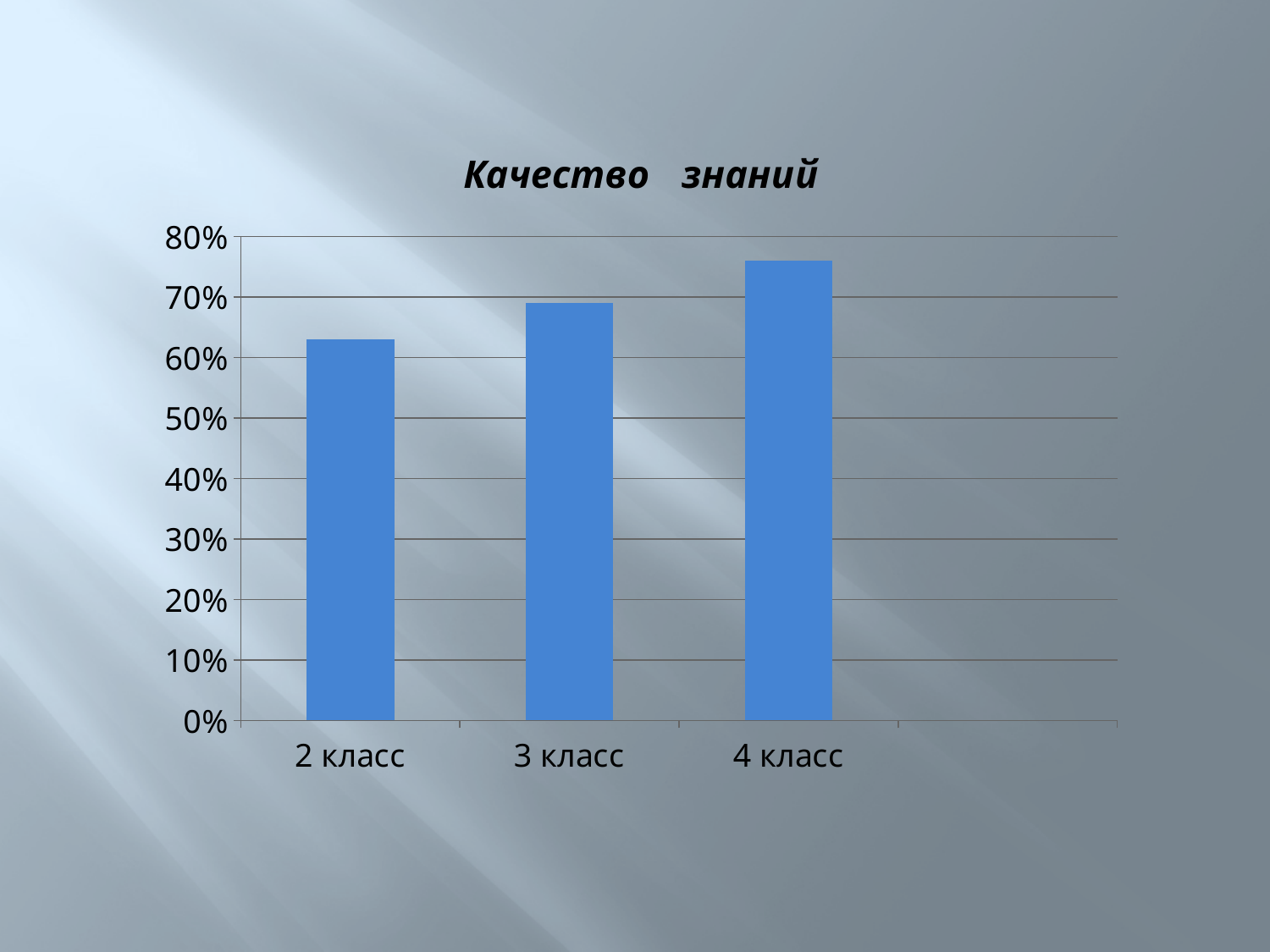
Which is larger, the value for 2 класс or the value for 3 класс? 3 класс What kind of chart is shown on the slide? bar chart Is the value for 2 класс greater or less than 60%? greater What is the title of the chart? Качество знаний Which is larger, the value for 2 класс or the value for 4 класс? 4 класс Do the values rise or fall from 2 класс to 4 класс? rise Is the value for 2 класс greater or less than 70%? less Is the value for 4 класс greater or less than 70%? greater Which category has the highest value? 4 класс How many categories are shown on the x axis? 3 Which category has the lowest value? 2 класс